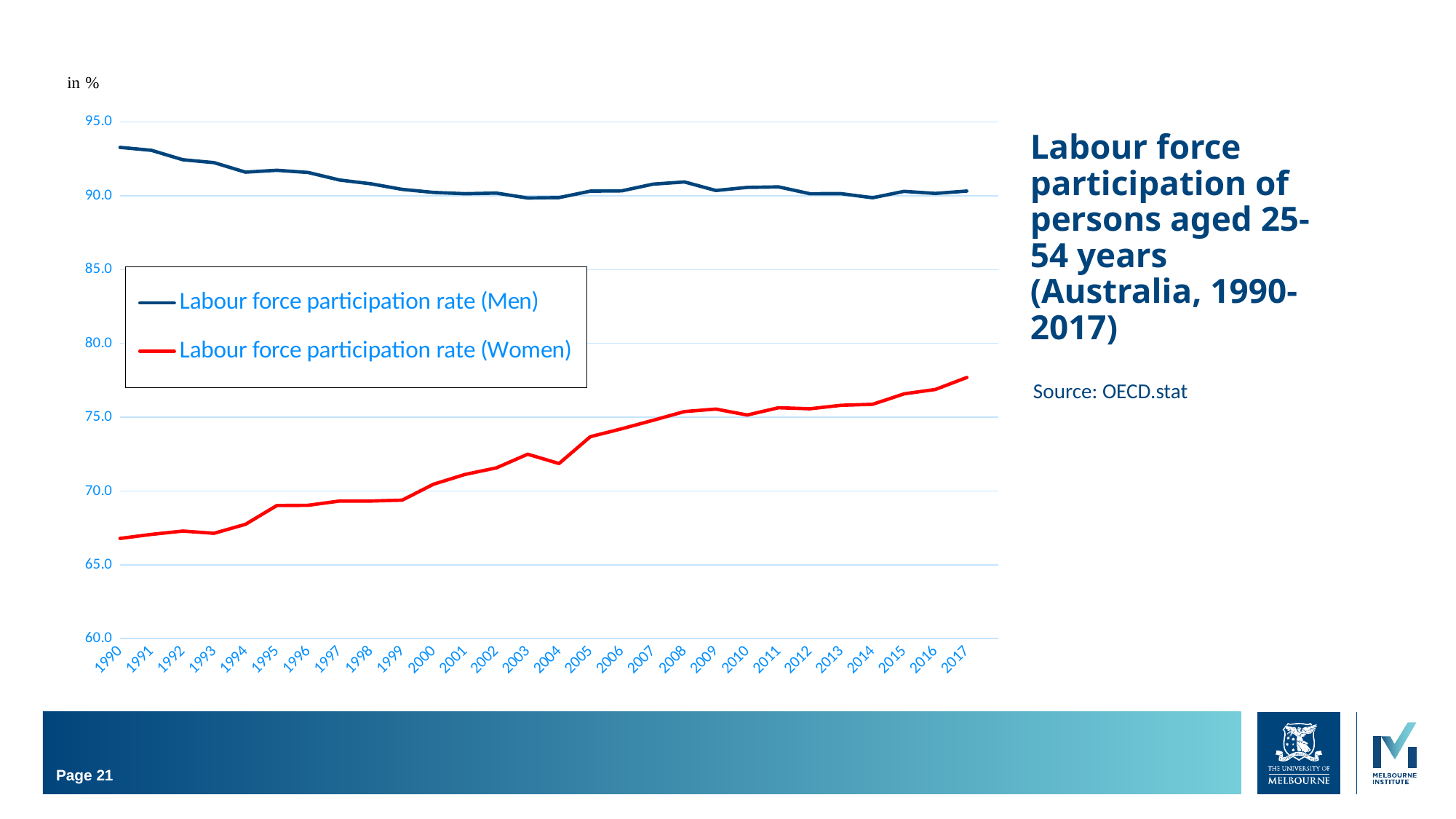
What is the source cited for the chart? OECD.stat What kind of chart is shown on the slide? line chart In which year is the labour force participation rate for women lowest? 1990 Does the labour force participation rate for women rise or fall from 1990 to 2017? rise Which series has the higher value in 2010, men or women? men How many series does the legend list? 2 Does the labour force participation rate for men rise or fall from 1990 to 2017? fall Is the labour force participation rate for women in 2017 greater or less than 75.0? greater Is the labour force participation rate for women in 1990 greater or less than 70.0? less In which year is the labour force participation rate for men highest? 1990 How many years are plotted along the x axis? 28 In which year is the labour force participation rate for women highest? 2017